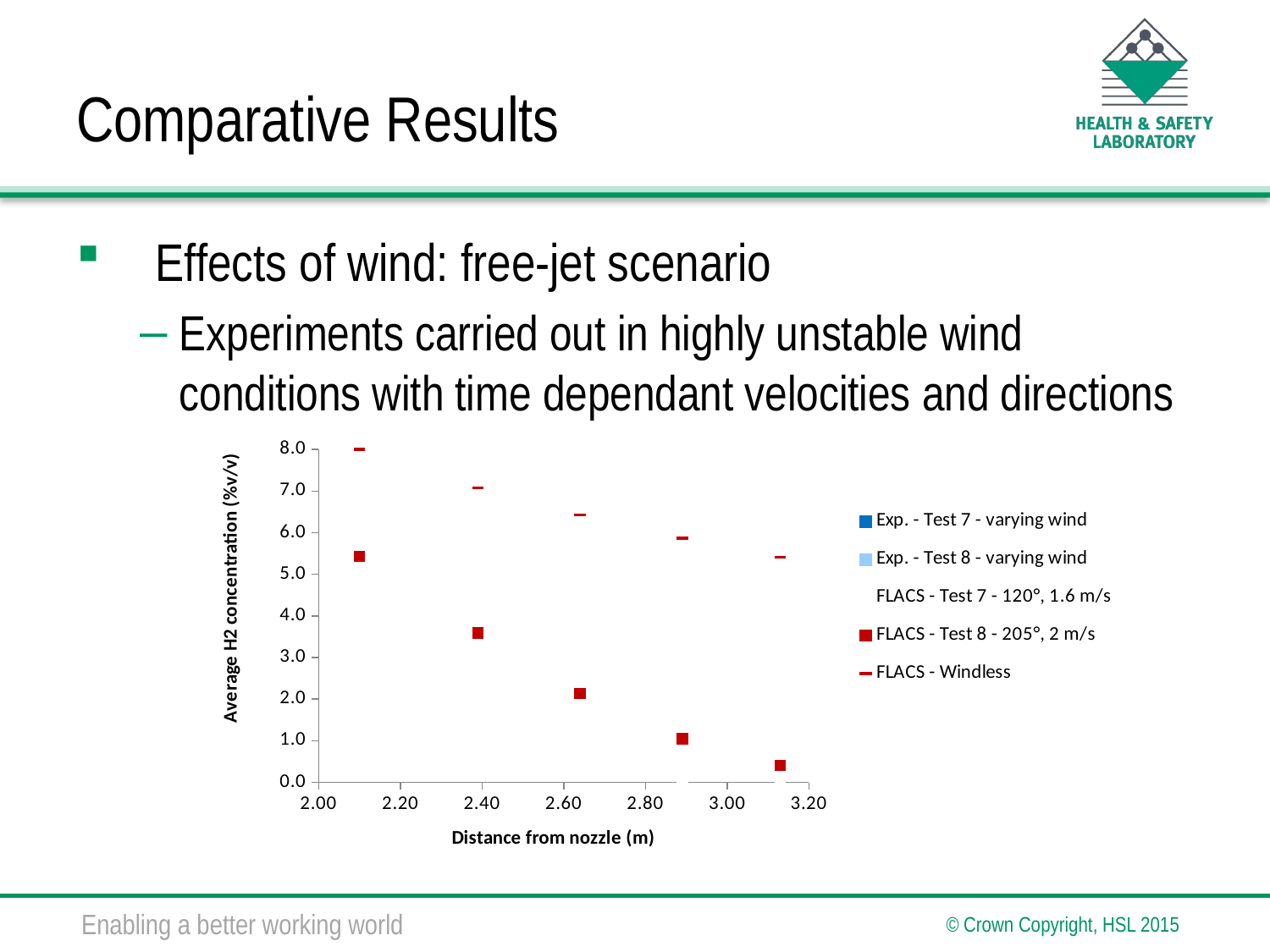
Is the value of the FLACS - Test 8 - 205°, 2 m/s series at its leftmost point (around 2.10 m) greater or less than 5.0? greater Is the value of the FLACS - Windless series at its rightmost point (around 3.15 m) greater or less than 5.0? greater Do the values of the FLACS - Test 8 - 205°, 2 m/s series rise or fall as distance from the nozzle increases? fall How many series does the chart legend list? 5 Do the values of the FLACS - Windless series rise or fall as distance from the nozzle increases? fall Is the value of the FLACS - Test 8 - 205°, 2 m/s series at around 2.40 m greater or less than 3.0? greater What is the title of the x axis of the chart? Distance from nozzle (m) How many data points are plotted for the FLACS - Windless series? 5 How many data points are plotted for the FLACS - Test 8 - 205°, 2 m/s series? 5 What kind of chart is shown on the slide? scatter chart At the leftmost plotted distance, which series has the higher H2 concentration: FLACS - Windless or FLACS - Test 8 - 205°, 2 m/s? FLACS - Windless